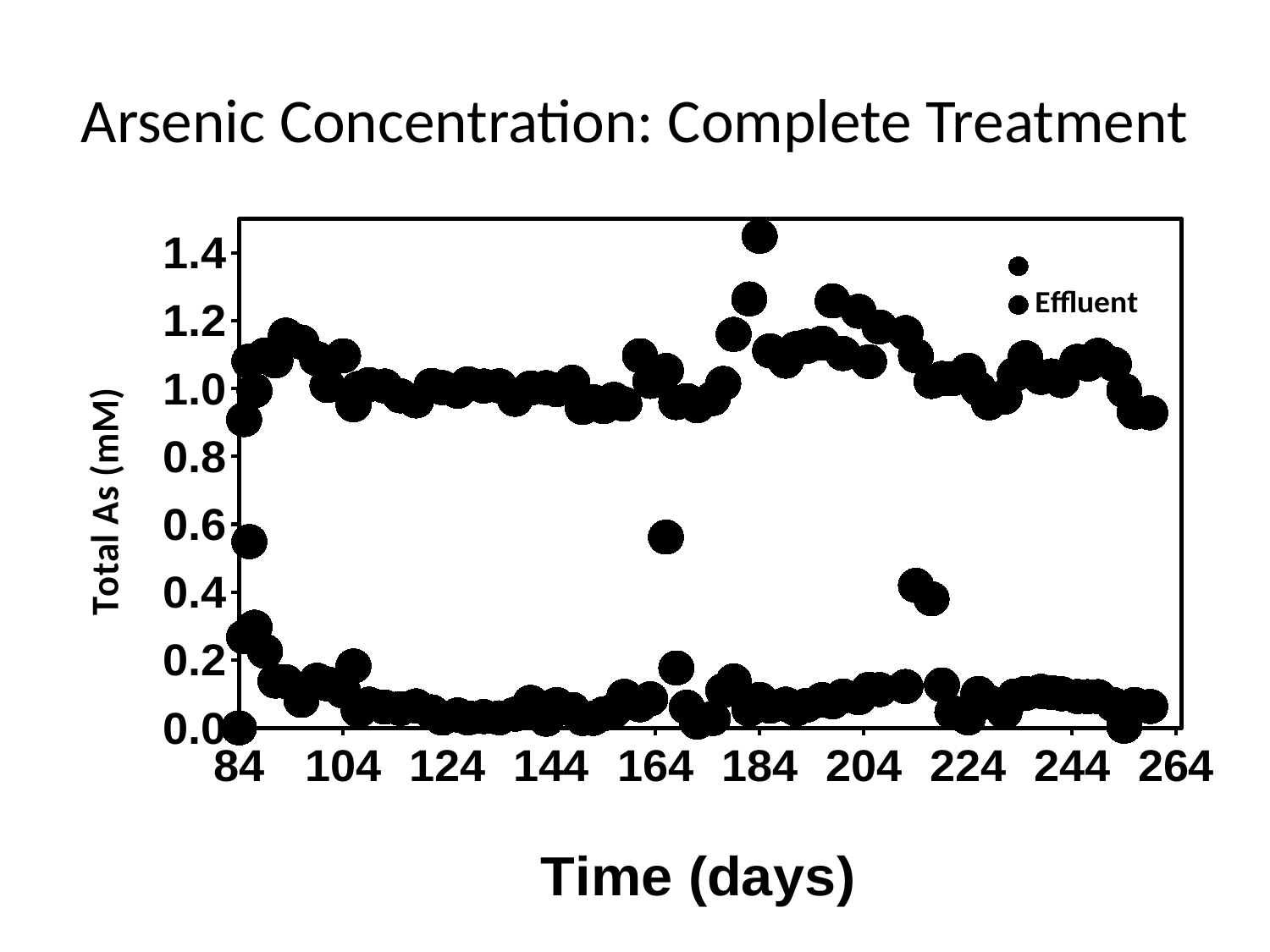
What is the label of the x axis? Time (days) Are the upper group of points around day 124 greater or less than 0.8? greater What is the last tick value on the x axis? 264 What kind of chart is shown on the slide? scatter plot What is the highest value shown on the y axis? 1.4 Are the lower group of points around day 144 greater or less than 0.2? less Is the isolated point near day 164 that sits between the two groups greater or less than 0.4? greater What is the first tick value on the x axis? 84 Do the lower group of points rise or fall between day 84 and day 124? fall What is the title of the chart? Arsenic Concentration: Complete Treatment How many tick values are labelled on the x axis? 10